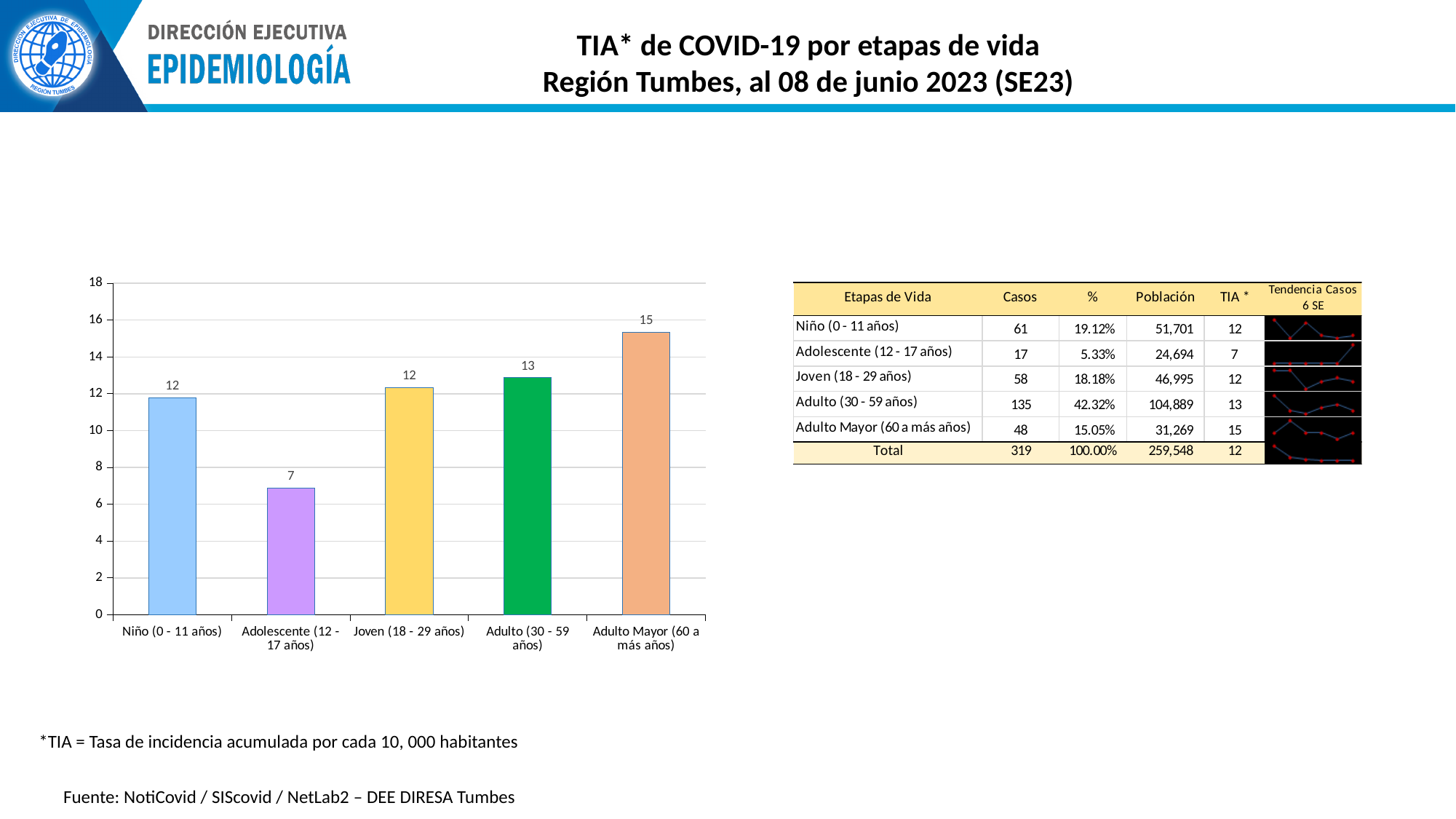
Which has a larger TIA label, Adulto (30 - 59 años) or Joven (18 - 29 años)? Adulto (30 - 59 años) Which life stage has the lowest TIA in the bar chart? Adolescente (12 - 17 años) What is the maximum value shown on the vertical axis of the bar chart? 18 What is the TIA value shown for Adulto (30 - 59 años)? 13 What is the difference between the TIA labels for Adulto Mayor (60 a más años) and Adolescente (12 - 17 años)? 8 How many life-stage categories are shown in the bar chart? 5 Is the bar for Adolescente (12 - 17 años) greater or less than 8? less What is the TIA value shown for Adolescente (12 - 17 años)? 7 What is the TIA value shown for Adulto Mayor (60 a más años)? 15 Which life stage has the highest TIA in the bar chart? Adulto Mayor (60 a más años) Is the bar for Adulto Mayor (60 a más años) greater or less than 14? greater What type of chart is used to show TIA by life stage? bar chart